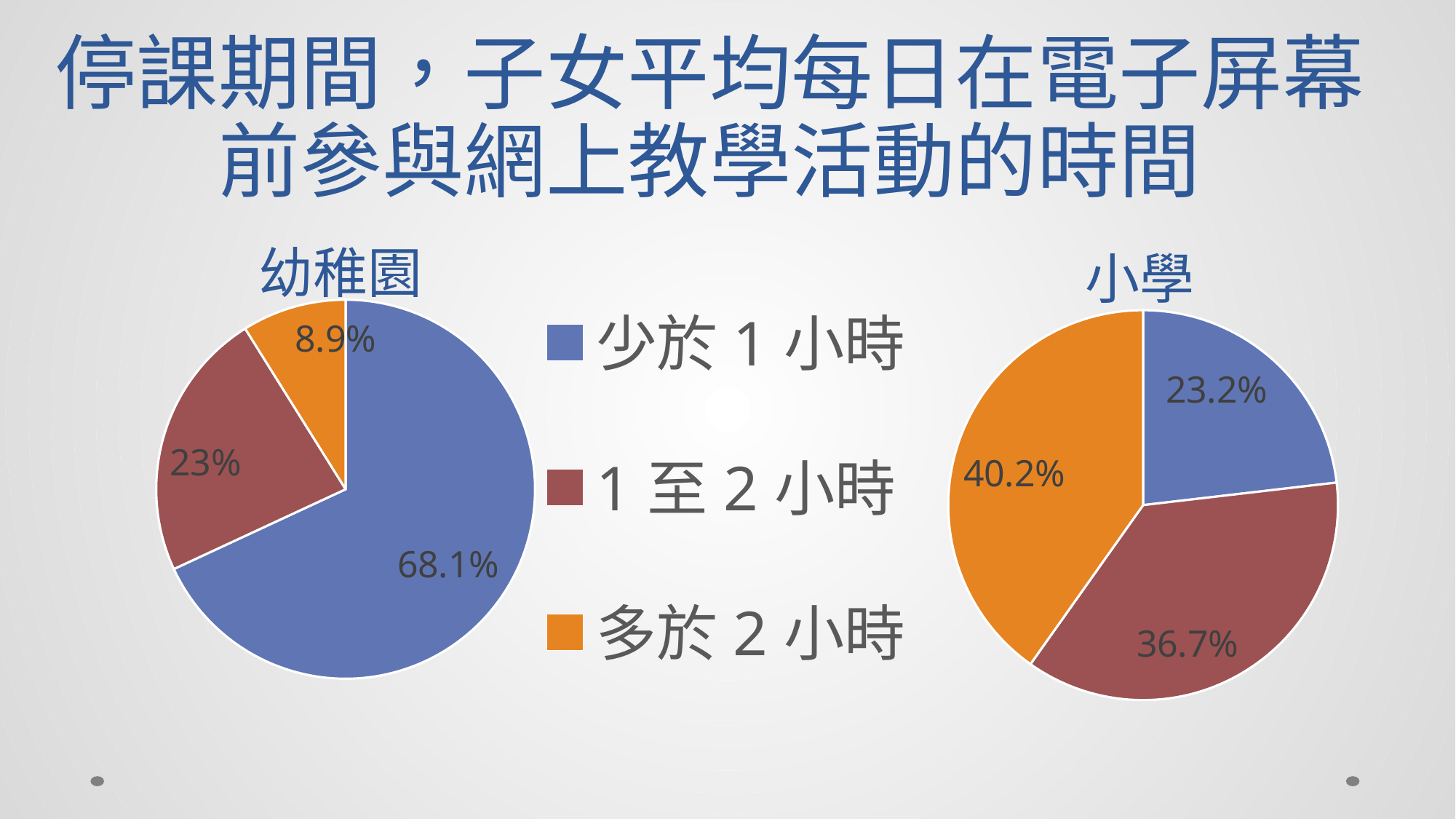
In the 小學 pie chart, which is larger: the share for 1 至 2 小時 or the share for 少於 1 小時? 1 至 2 小時 How many categories does the legend list for the pie charts? 3 In the 幼稚園 pie chart, what is the difference between the shares for 少於 1 小時 and 1 至 2 小時? 45.1% What type of chart is the 小學 chart? Pie chart In the 幼稚園 pie chart, what is the share for 1 至 2 小時? 23% In the 幼稚園 pie chart, what is the share for 多於 2 小時? 8.9% In the 小學 pie chart, which category has the largest share? 多於 2 小時 In the 幼稚園 pie chart, what is the share for 少於 1 小時? 68.1% In the 小學 pie chart, what is the share for 少於 1 小時? 23.2% In the 幼稚園 pie chart, which category has the smallest share? 多於 2 小時 In the 小學 pie chart, which category has the smallest share? 少於 1 小時 In the 小學 pie chart, what is the share for 多於 2 小時? 40.2%